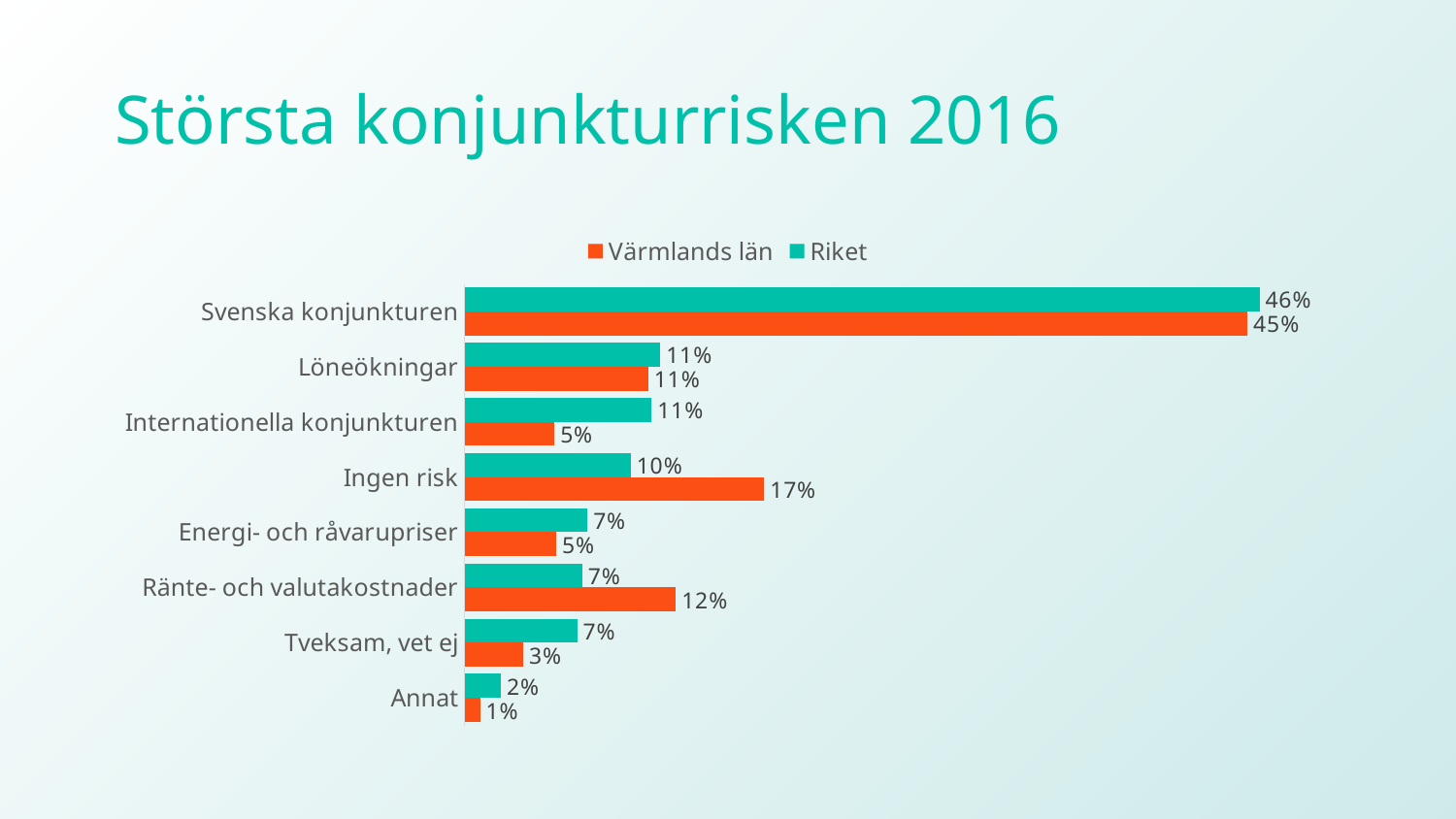
What is the title of the slide? Största konjunkturrisken 2016 What is the value for Värmlands län for Ingen risk? 17% Which category has the lowest value for Riket? Annat What kind of chart is shown on the slide? Bar chart Which category has the highest value for Värmlands län? Svenska konjunkturen What is the value for Riket for Svenska konjunkturen? 46% Which is larger for Ingen risk: Värmlands län or Riket? Värmlands län How many categories are shown on the chart? 8 What is the value for Värmlands län for Internationella konjunkturen? 5% What is the difference between Värmlands län and Riket for Ränte- och valutakostnader? 5% What is the value for Riket for Tveksam, vet ej? 7% How many series does the legend list? 2